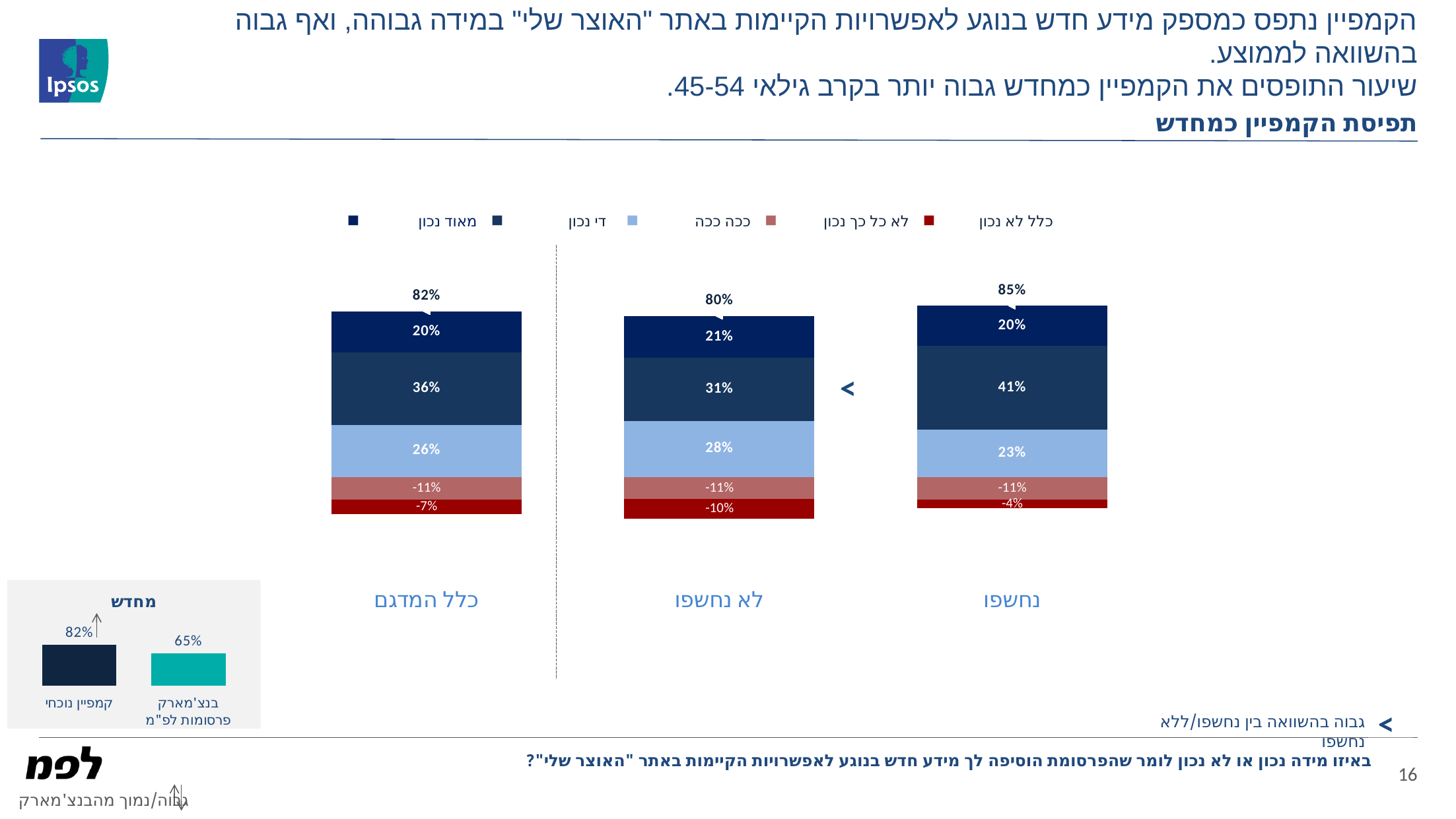
In the main stacked bar chart, which category has the lowest total shown above its bar? לא נחשפו In the main stacked bar chart, what is the value of the 'ככה ככה' segment for כלל המדגם? 26% In the main stacked bar chart, which category has the highest total shown above its bar? נחשפו In the main stacked bar chart, what is the difference between the 'די נכון' values for נחשפו and לא נחשפו? 10% In the main stacked bar chart, what is the total percentage shown above the bar for נחשפו? 85% How many categories are shown in the main stacked bar chart? 3 In the main stacked bar chart, what is the value of the 'מאוד נכון' segment for לא נחשפו? 21% How many series does the legend of the main stacked bar chart list? 5 In the main stacked bar chart, what is the value of the 'כלל לא נכון' segment for נחשפו? -4% In the small chart titled 'מחדש' at the bottom left, what is the value for קמפיין נוכחי? 82% In the main stacked bar chart (תפיסת הקמפיין כמחדש), what is the value of the 'די נכון' segment for נחשפו? 41% In the main stacked bar chart, which is larger: the 'ככה ככה' value for לא נחשפו or for נחשפו? לא נחשפו